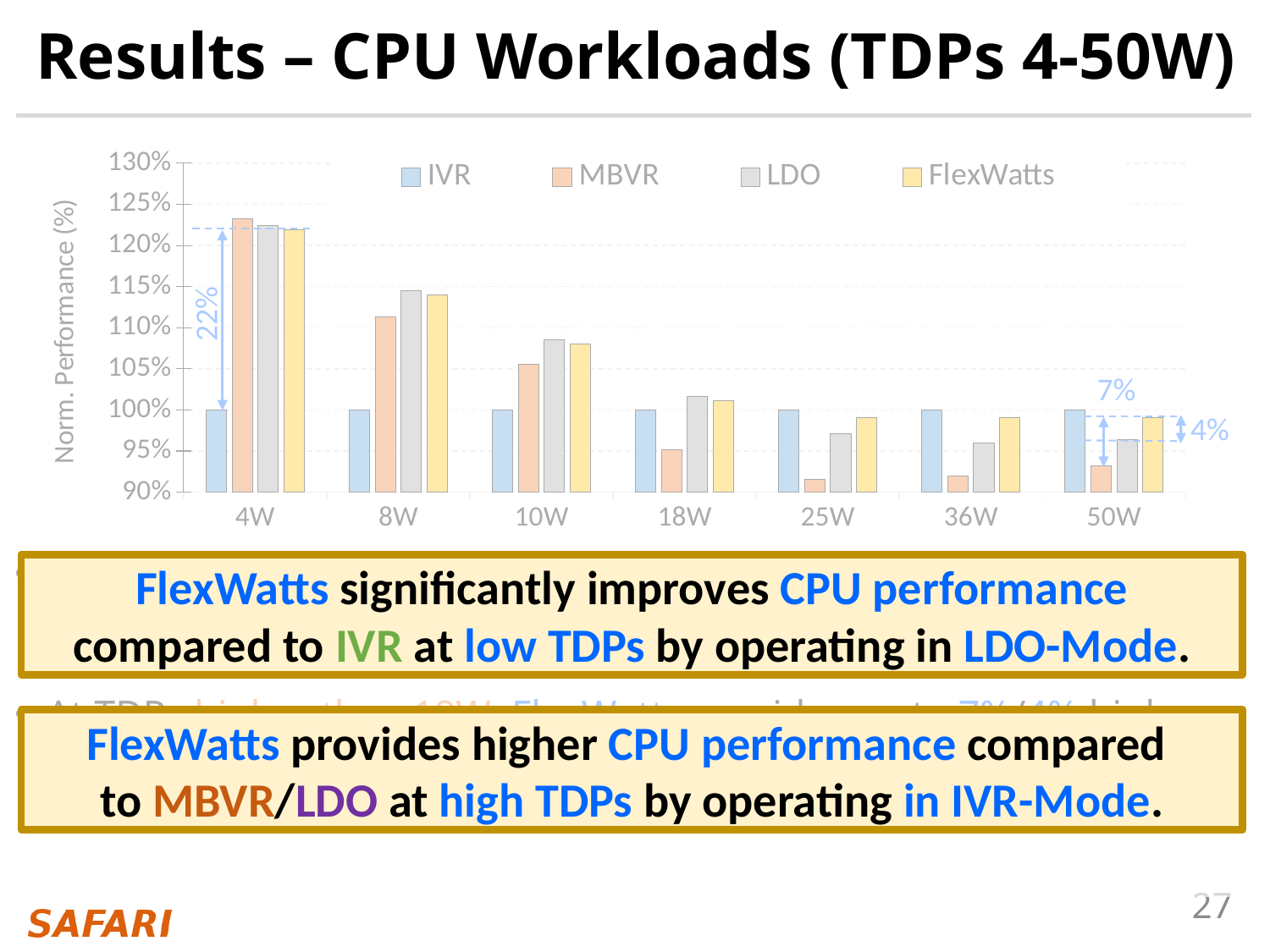
How many TDP categories are shown on the x axis? 7 Does the MBVR value rise or fall from 4W to 25W? fall Is the value for MBVR at 4W greater or less than 120%? greater Which series has the lowest value at 25W? MBVR How many series does the legend list? 4 At 8W, which is larger: MBVR or LDO? LDO What is the label of the y axis? Norm. Performance (%) Is the value for LDO at 8W greater or less than 110%? greater Is the value for LDO at 10W greater or less than 105%? greater What is the normalized performance of IVR at 4W? 100% What kind of chart is shown on the slide? bar chart